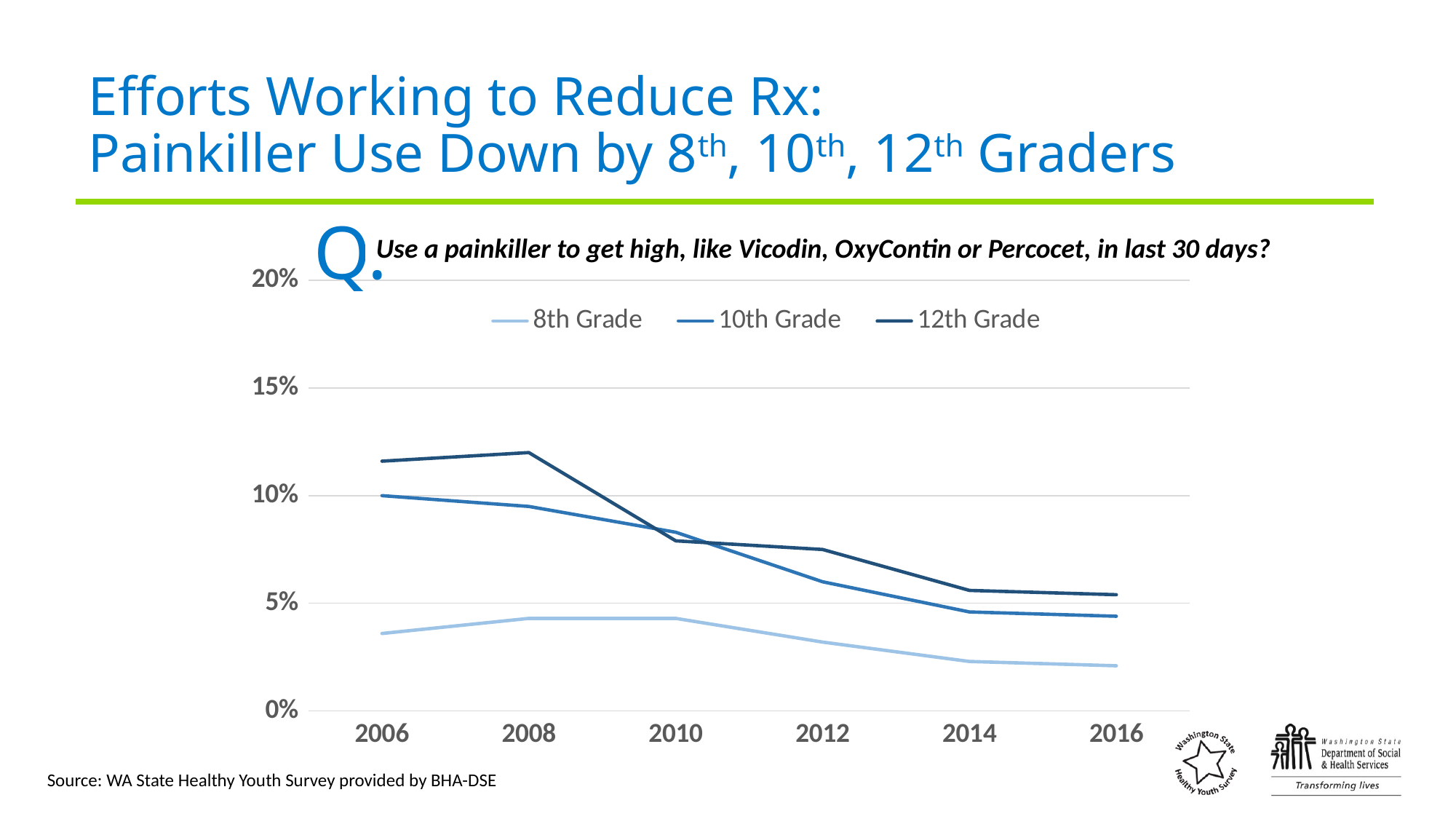
Is the value for 10th Grade in 2014 greater or less than 5%? less Is the value for 12th Grade in 2008 greater or less than 10%? greater Which grade has the lowest value in 2006? 8th Grade How many series does the legend list? 3 Does the 10th Grade line rise or fall from 2006 to 2016? fall How many years are shown along the x axis? 6 What kind of chart is shown on the slide? line chart In 2006, which is larger: the value for 12th Grade or the value for 10th Grade? 12th Grade Is the value for 12th Grade in 2012 greater or less than 5%? greater Which grade has the highest value in 2016? 12th Grade Which series does the legend list: name them in order. 8th Grade, 10th Grade, 12th Grade